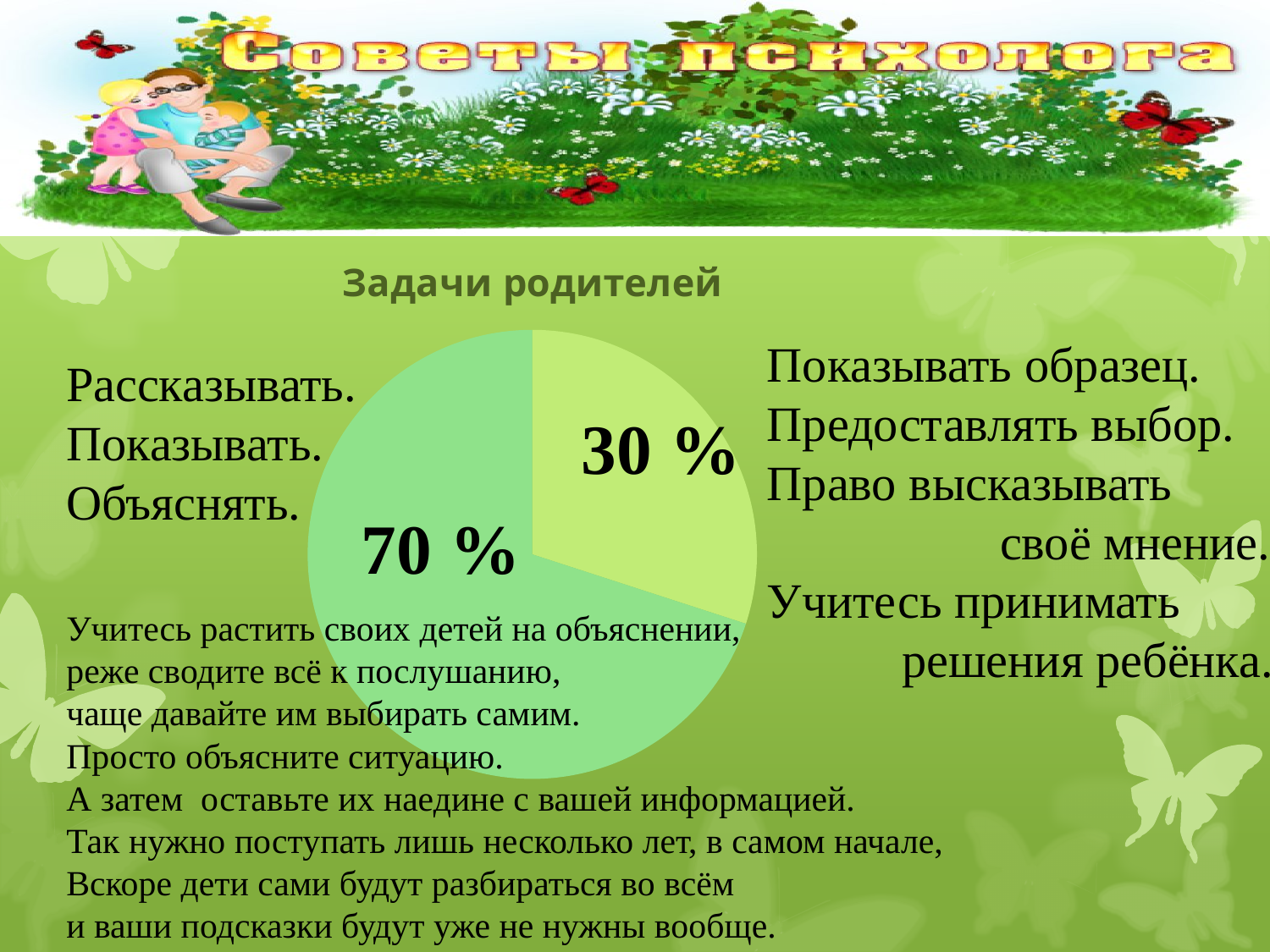
What is the value shown on the larger slice of the pie chart? 70 % Is the value of the larger slice greater or less than 50 %? greater Is the value of the smaller slice greater or less than 50 %? less What kind of chart is shown on the slide? pie chart Which slice is larger: the one labelled 30 % or the one labelled 70 %? 70 % What is the difference between the two slices of the pie chart? 40 % What share of the pie does the lighter green slice represent? 30 % What is the total of the two slices shown on the pie chart? 100 % How many slices does the pie chart have? 2 What is the value shown on the smaller slice of the pie chart? 30 % What share of the pie does the darker green slice represent? 70 % What is the title of the chart on the slide? Задачи родителей